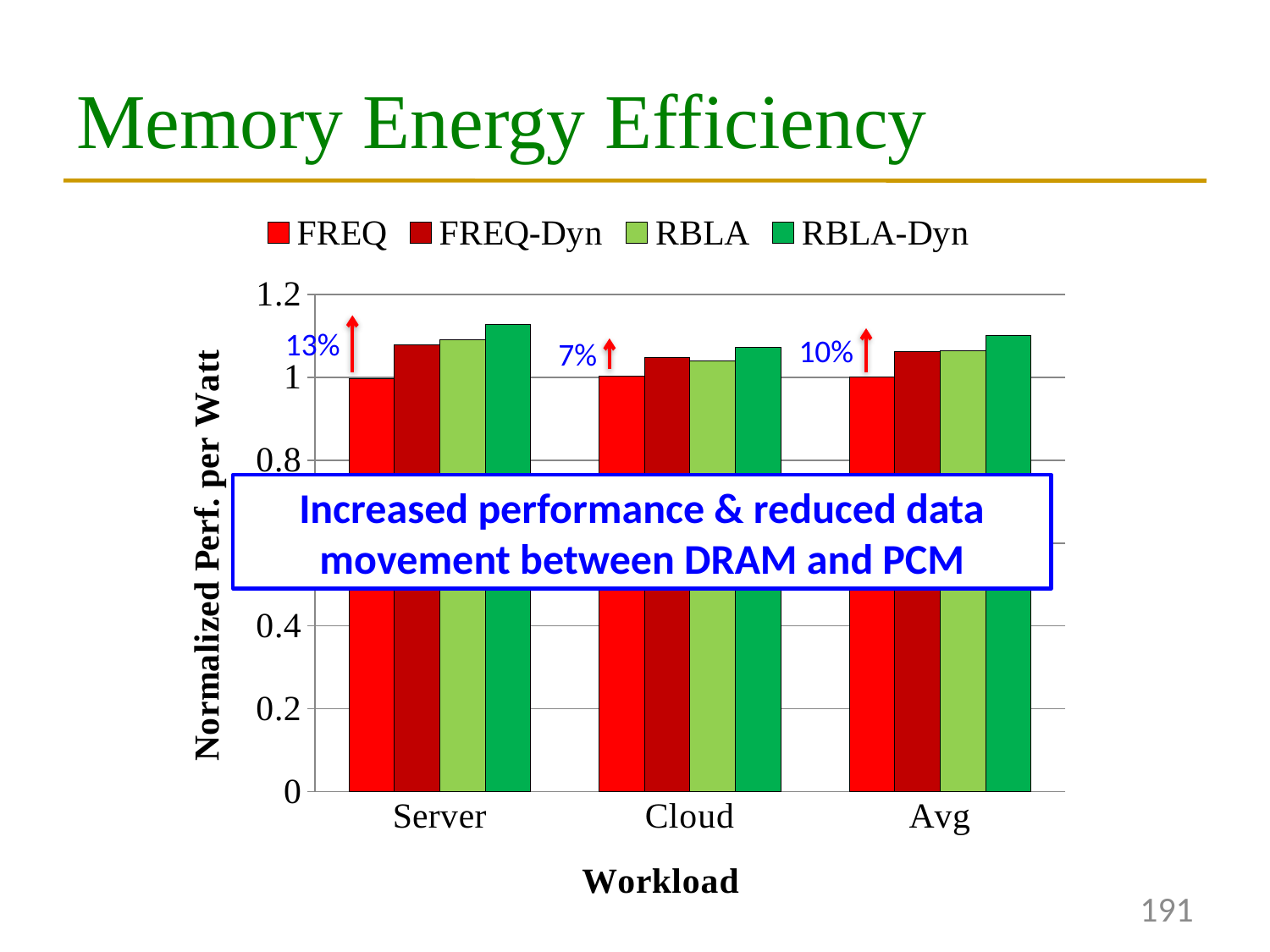
How many series does the legend list? 4 What percentage improvement is annotated above the Server group? 13% What percentage improvement is annotated above the Cloud group? 7% Which series has the highest bar for the Avg workload? RBLA-Dyn Which series has the highest bar for the Server workload? RBLA-Dyn What kind of chart is shown on the slide? bar chart Which is larger: the RBLA-Dyn value for Server or the RBLA-Dyn value for Cloud? Server Which series has the lowest bar for the Cloud workload? FREQ How many workload categories are shown on the x axis? 3 What is the title of the y axis? Normalized Perf. per Watt Is the RBLA-Dyn value for Server greater or less than 1? greater Is the FREQ-Dyn value for Cloud greater or less than 1.2? less